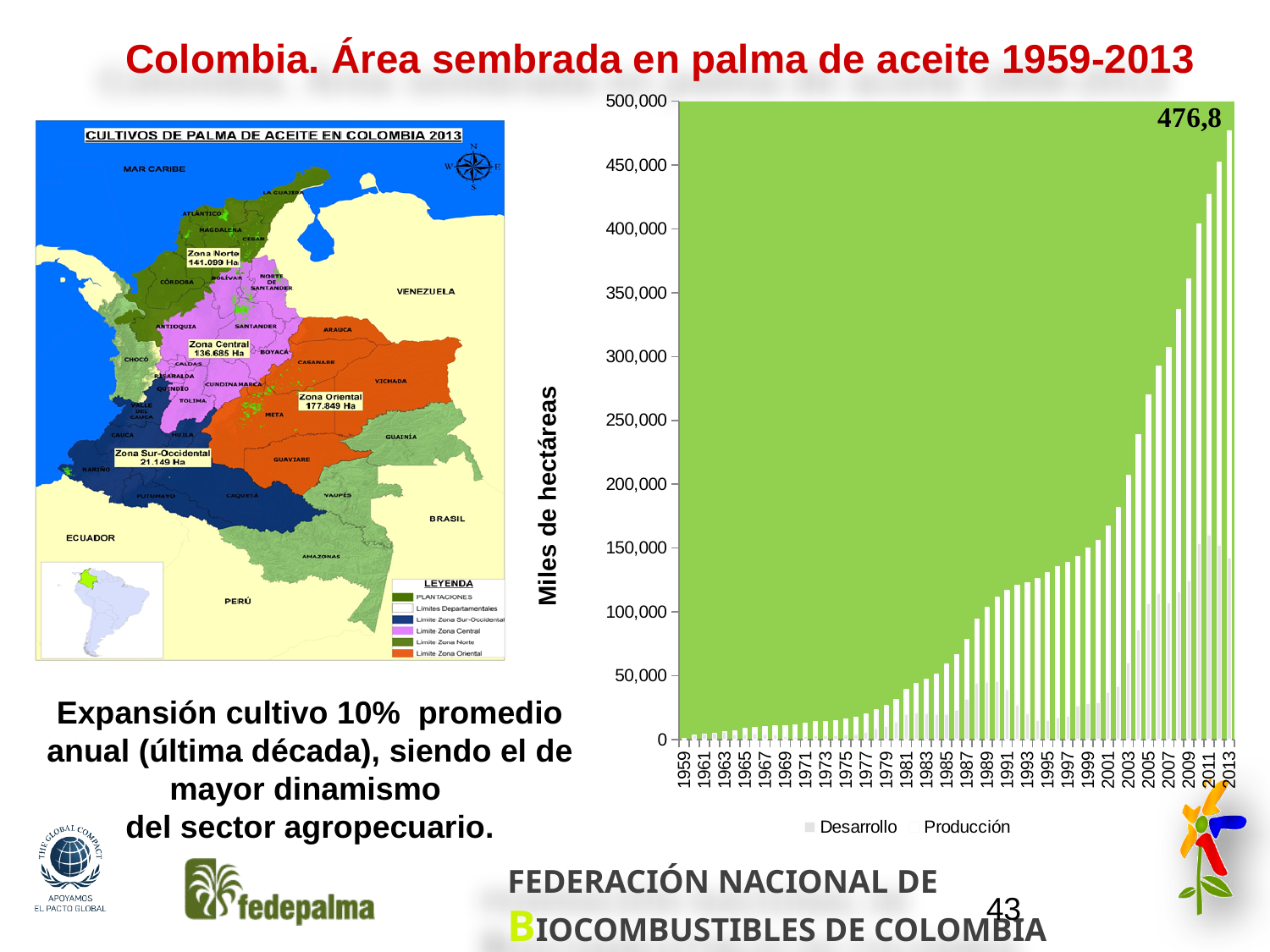
Do the bar heights generally rise or fall from 1959 to 2013? rise What value is printed as the data label on the bar for 2013? 476,8 Is the total bar for 1959 greater or less than 50,000? less Is the total bar for 2013 greater or less than 450,000? greater Is the total bar for 1999 greater or less than 200,000? less What kind of chart is shown on the right side of the slide? bar chart Which year has the shortest bar in the chart? 1959 Which year has the larger total bar, 1979 or 2009? 2009 What is the label on the vertical axis of the bar chart? Miles de hectáreas Which year has the tallest bar in the chart? 2013 How many series does the legend of the bar chart list? 2 What are the two series named in the legend of the bar chart? Desarrollo, Producción